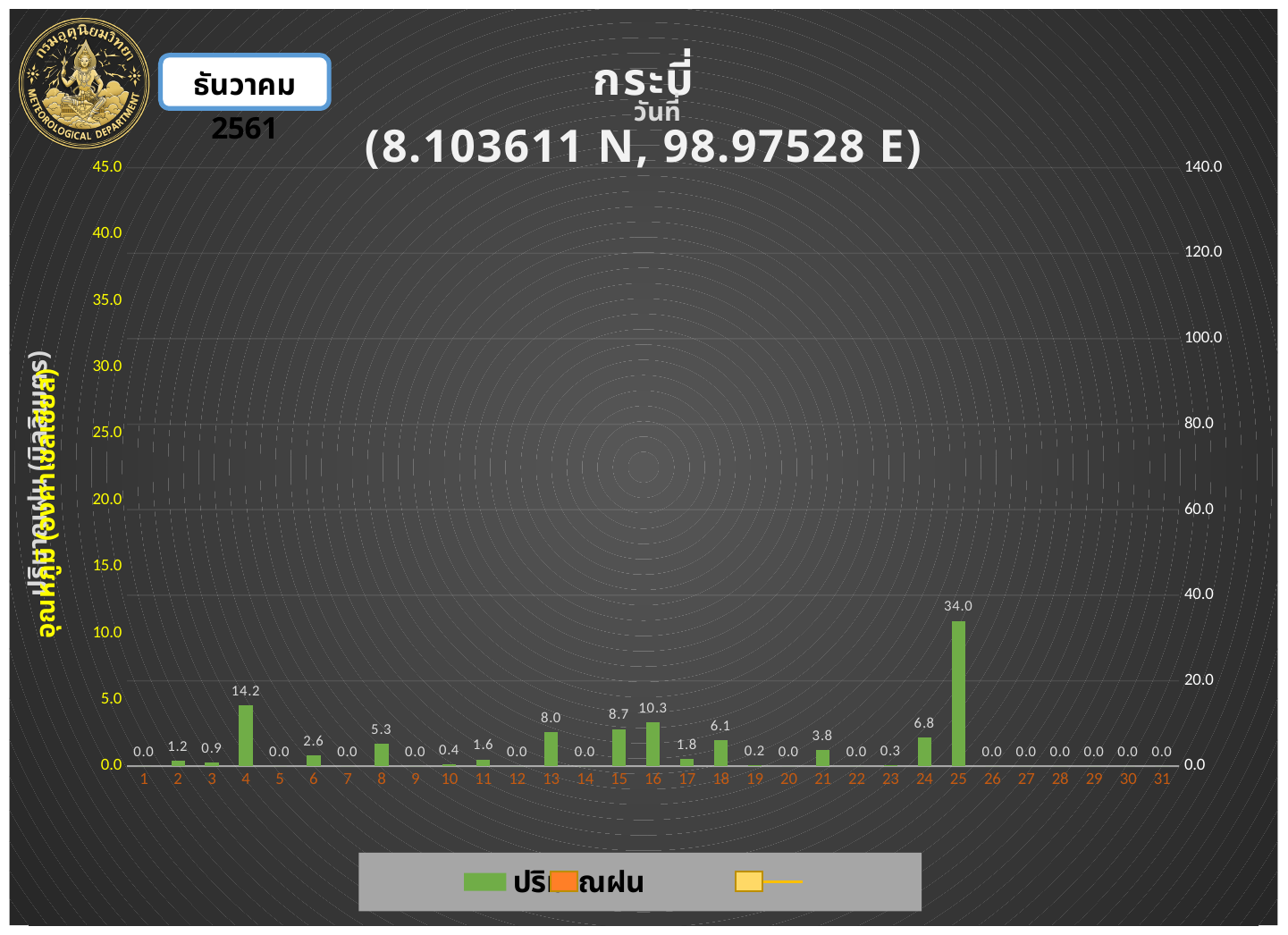
What is the rainfall value shown for day 16? 10.3 What is the rainfall value shown for day 8? 5.3 How many days are shown on the x axis? 31 Which has a larger rainfall value, day 24 or day 21? day 24 Which day has the highest rainfall value? 25 Which has a larger rainfall value, day 13 or day 18? day 13 What is the difference between the rainfall values for day 16 and day 15? 1.6 What is the rainfall value shown for day 4? 14.2 What is the rainfall value shown for day 25? 34.0 What kind of chart is shown on the slide? bar chart What coordinates are given in the chart title? 8.103611 N, 98.97528 E What is the difference between the rainfall values for day 25 and day 4? 19.8